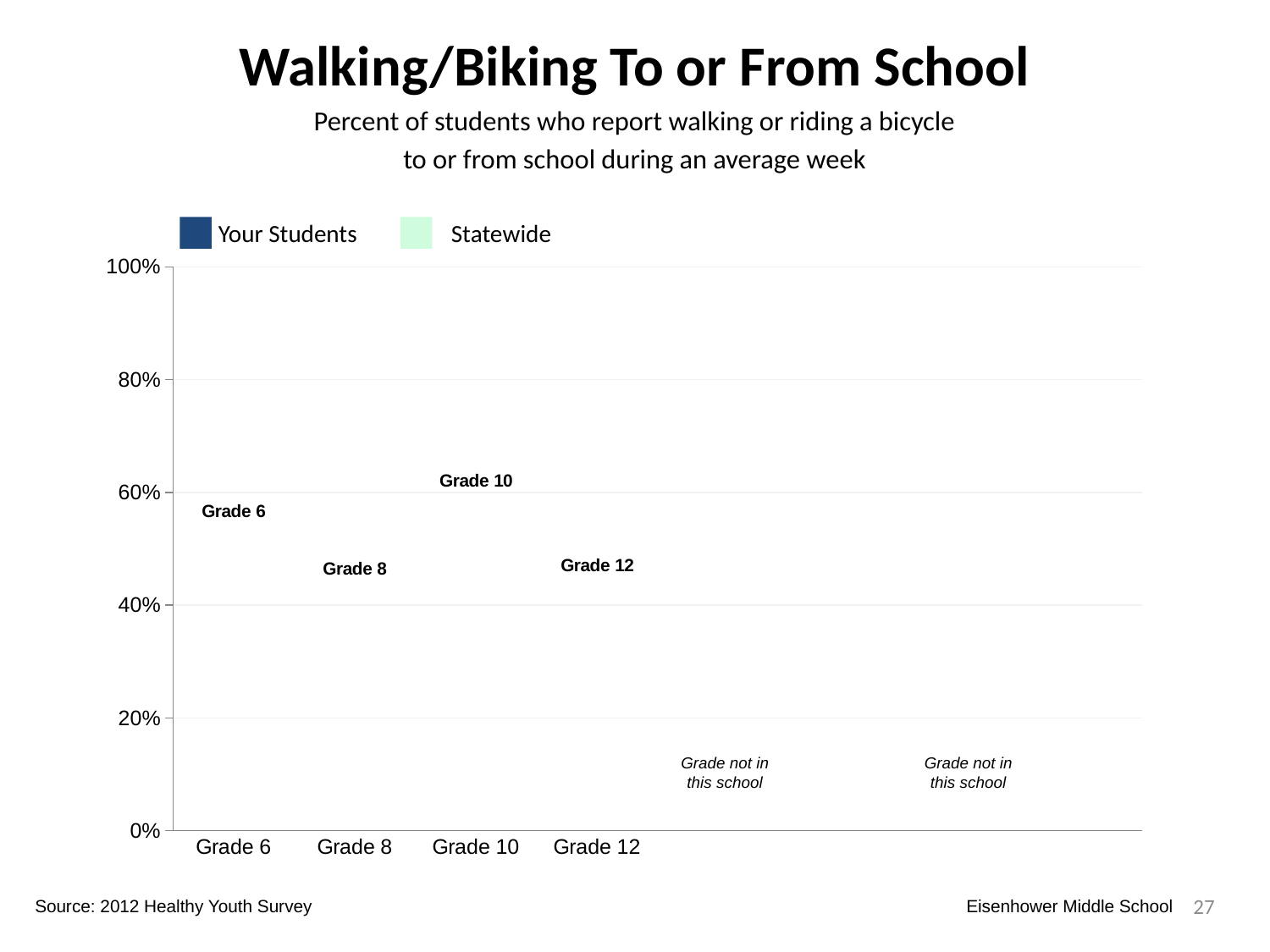
What is the highest value shown on the y axis? 100% What is the last category on the x axis? Grade 12 What is the title of the chart? Walking/Biking To or From School What is the first category on the x axis? Grade 6 How many grade categories are labeled on the x axis? 4 What are the two series named in the legend? Your Students and Statewide How many series does the legend list? 2